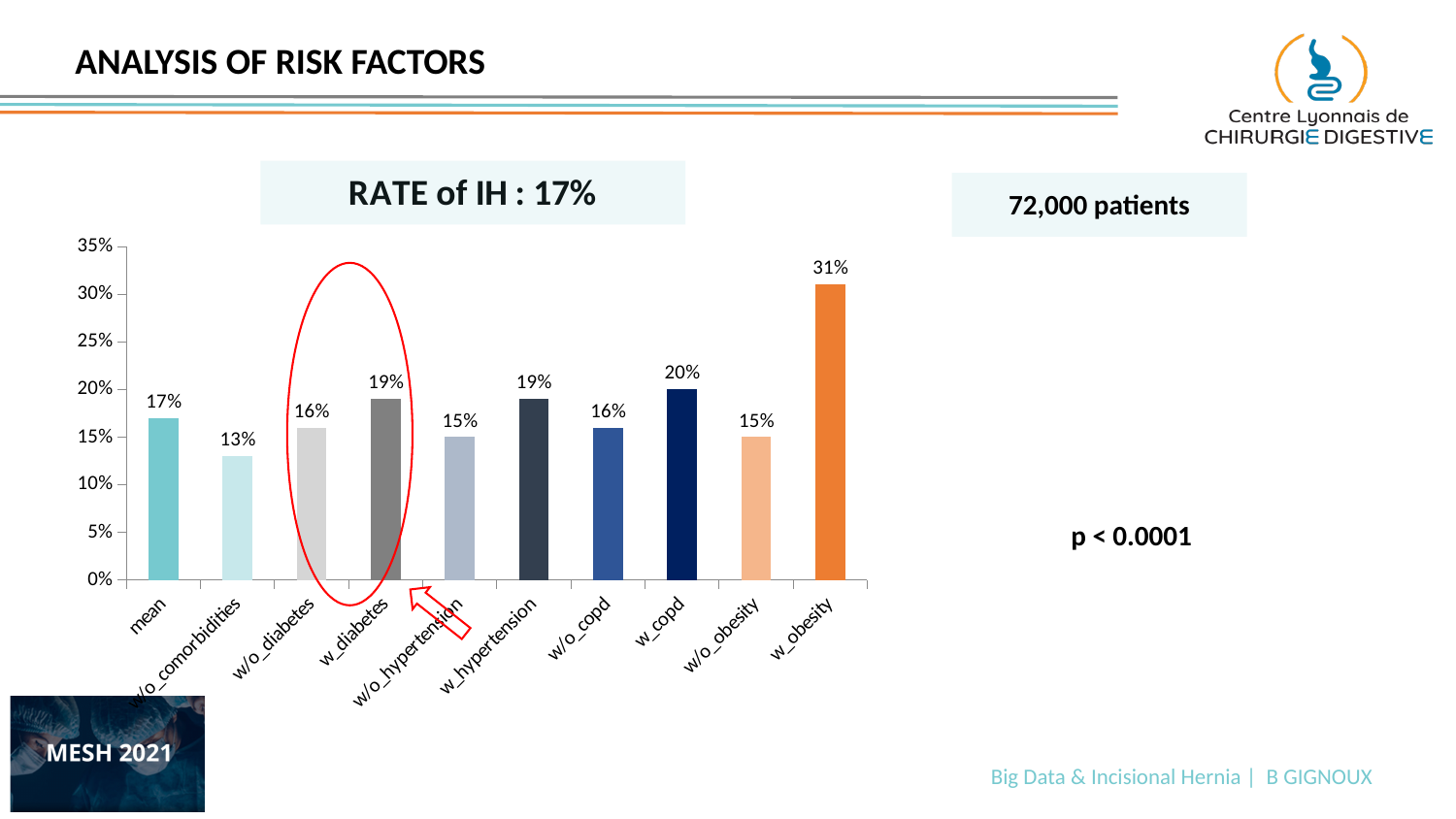
Which category has the lowest value? w/o_comorbidities What is the difference between the values for w_diabetes and w/o_diabetes? 3% What is the value for w_obesity? 31% How many categories are shown on the x axis? 10 What is the value for w_diabetes? 19% What rate of IH is stated in the box above the chart? 17% What is the value for w_copd? 20% Which is larger, the value for w_copd or the value for w/o_copd? w_copd What is the value for w/o_comorbidities? 13% What kind of chart is shown on the slide? bar chart What is the difference between the values for w_obesity and w/o_obesity? 16% Which category has the highest value? w_obesity